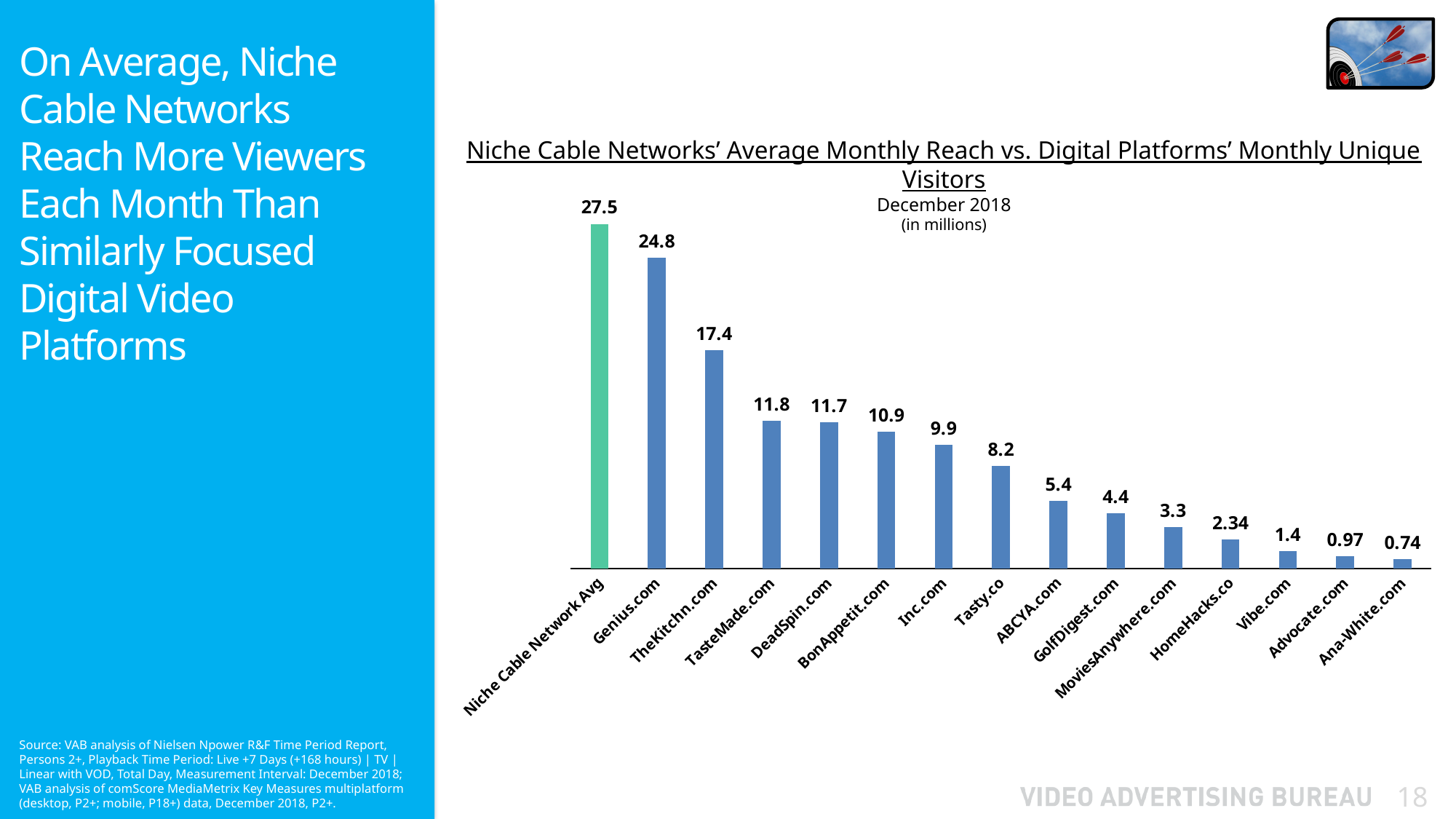
Which has a larger value, BonAppetit.com or Inc.com? BonAppetit.com What is the difference between the values for TasteMade.com and DeadSpin.com? 0.1 How many categories are shown in the chart? 15 What kind of chart is shown on the slide? Bar chart What is the value for Niche Cable Network Avg? 27.5 Which category has the highest value? Niche Cable Network Avg What is the value for HomeHacks.co? 2.34 What is the value for Tasty.co? 8.2 Which category has the lowest value? Ana-White.com Do the values rise or fall from left to right along the x axis? Fall What is the difference between the values for Niche Cable Network Avg and Genius.com? 2.7 What is the value for TheKitchn.com? 17.4